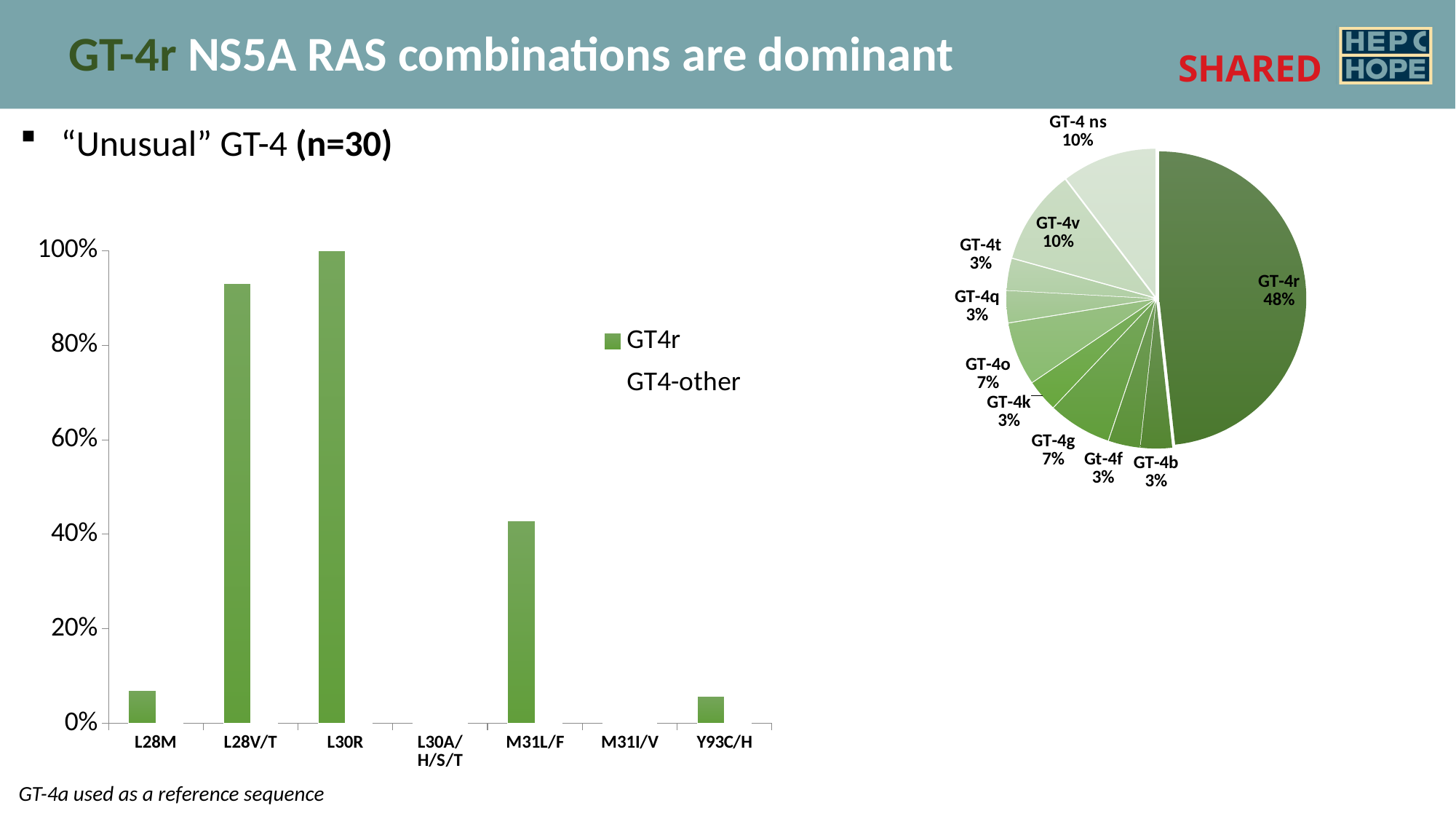
In the pie chart, which slice is the largest? GT-4r In the pie chart, what share does GT-4r have? 48% In the bar chart, which category has the highest value? L30R How many series does the legend of the bar chart list? 2 How many slices does the pie chart have? 10 In the bar chart, is the value for L28V/T greater or less than 80%? greater How many categories are shown on the x axis of the bar chart? 7 In the pie chart, what percentage is shown for GT-4o? 7% What kind of chart is the chart on the left of the slide? Bar chart In the bar chart, what is the value for L30R? 100% In the pie chart, what is the difference between the GT-4r share and the GT-4v share? 38 percentage points In the bar chart, which is larger, the value for M31L/F or the value for L28M? M31L/F